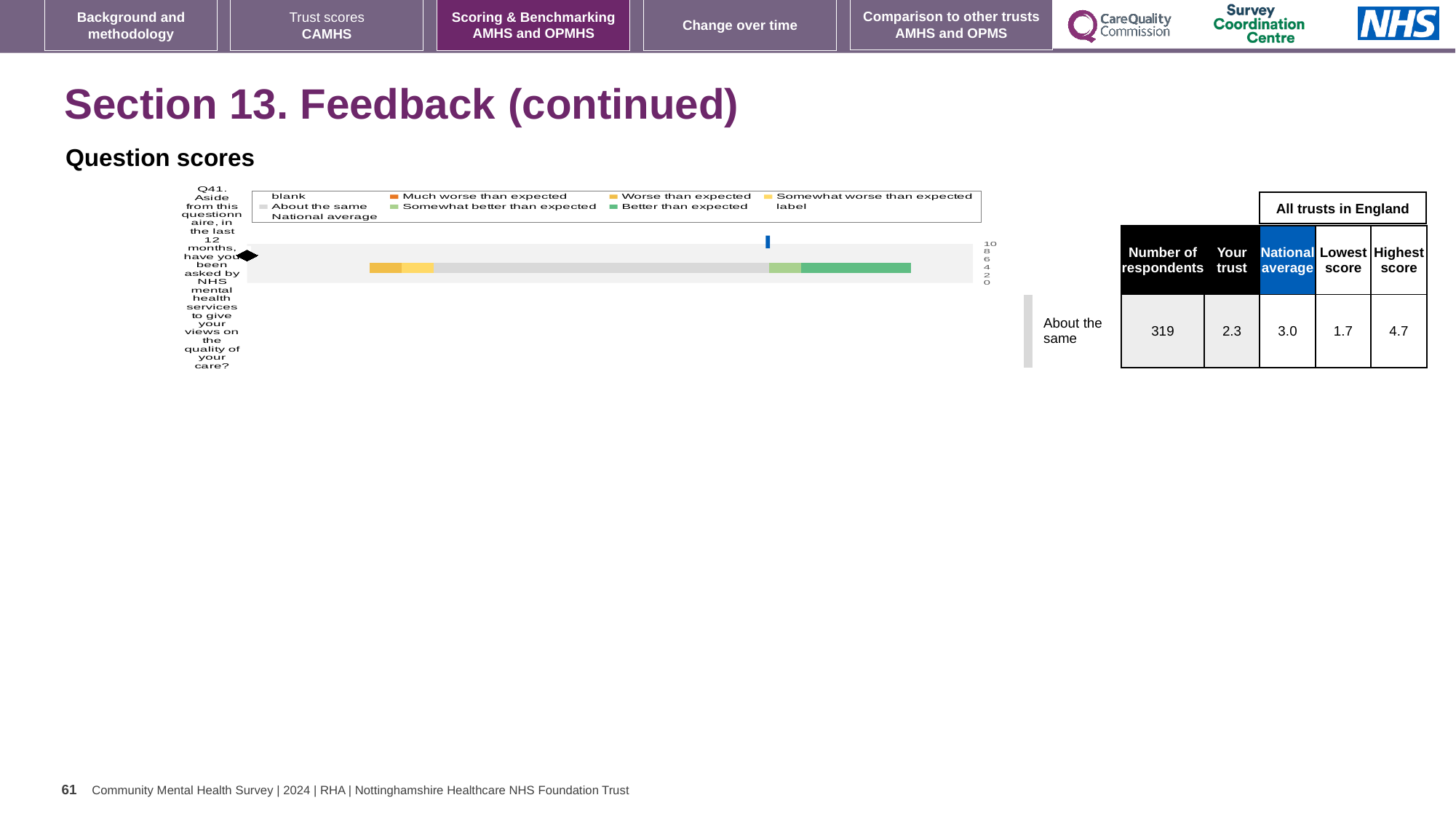
In the table next to the chart, what is the lowest score among all trusts in England for Q41? 1.7 In the table next to the chart, what is the 'Your trust' score for Q41? 2.3 In the table next to the chart, what is the highest score among all trusts in England for Q41? 4.7 How many entries does the chart legend list? 9 Which question number is plotted in the chart? Q41 In the table next to the chart, what is the national average for Q41? 3.0 Which is larger for Q41, the trust's score or the national average? national average In the table next to the chart, what is the number of respondents for Q41? 319 According to the label beside the chart, how does the trust's score for Q41 compare to what is expected? About the same How many questions (categories) are plotted in the chart? 1 What is the difference between the highest score and the lowest score for Q41 in the table? 3.0 What kind of chart is shown on the slide? bar chart